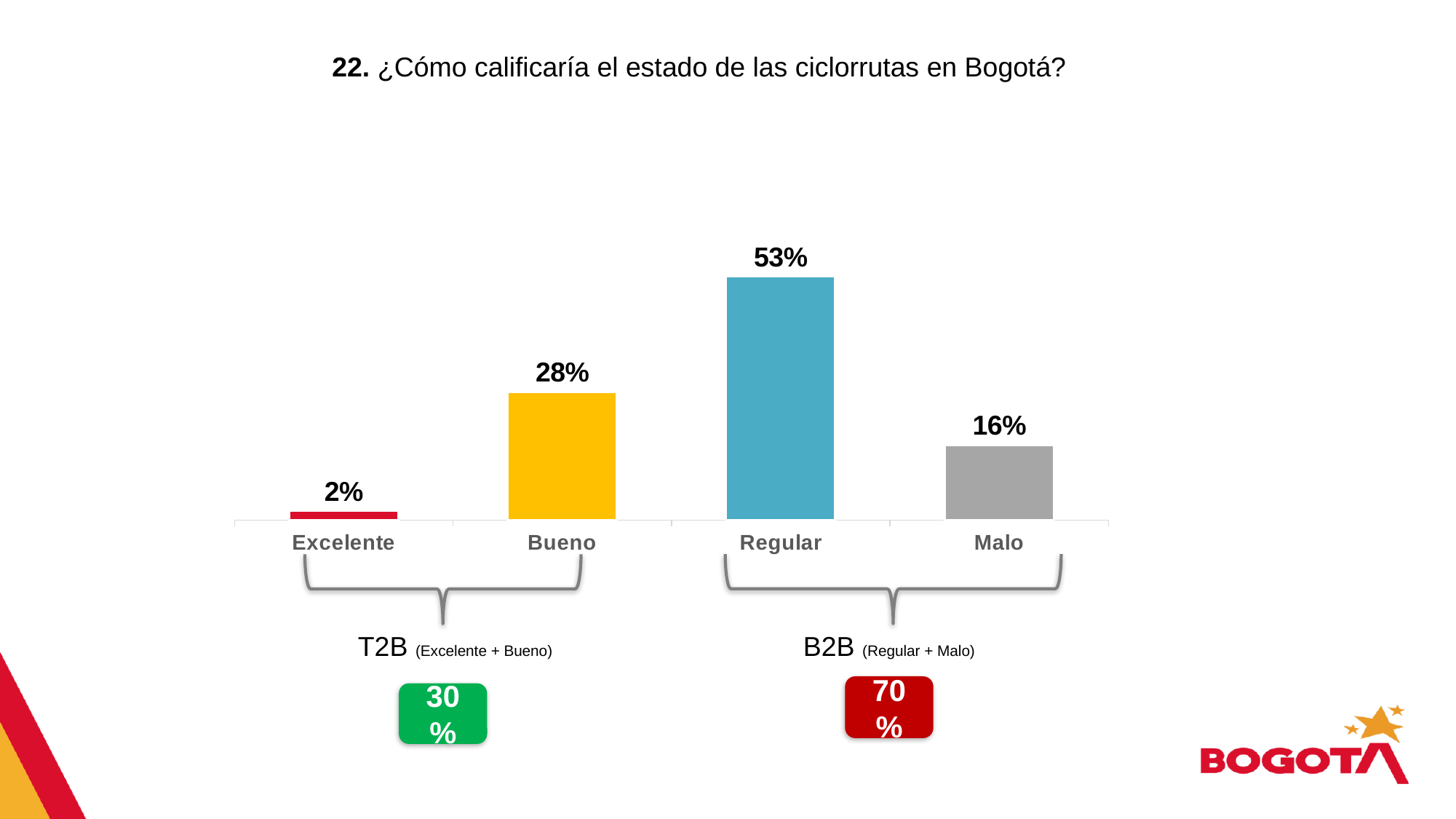
Which category has the highest value? Regular What is the value shown for the Excelente category? 2% How many categories are shown on the x axis of the chart? 4 What kind of chart is shown on the slide? Bar chart What percentage of respondents rated the state of the ciclorrutas as Regular? 53% What is the value shown for the Bueno category? 28% What is the T2B (Excelente + Bueno) value shown on the slide? 30% What colour is the bar for the Regular category? Blue Which category has the lowest value? Excelente Which is larger, the value for Bueno or the value for Malo? Bueno What is the value shown for the Malo category? 16% What is the difference between the Regular and Malo values? 37%